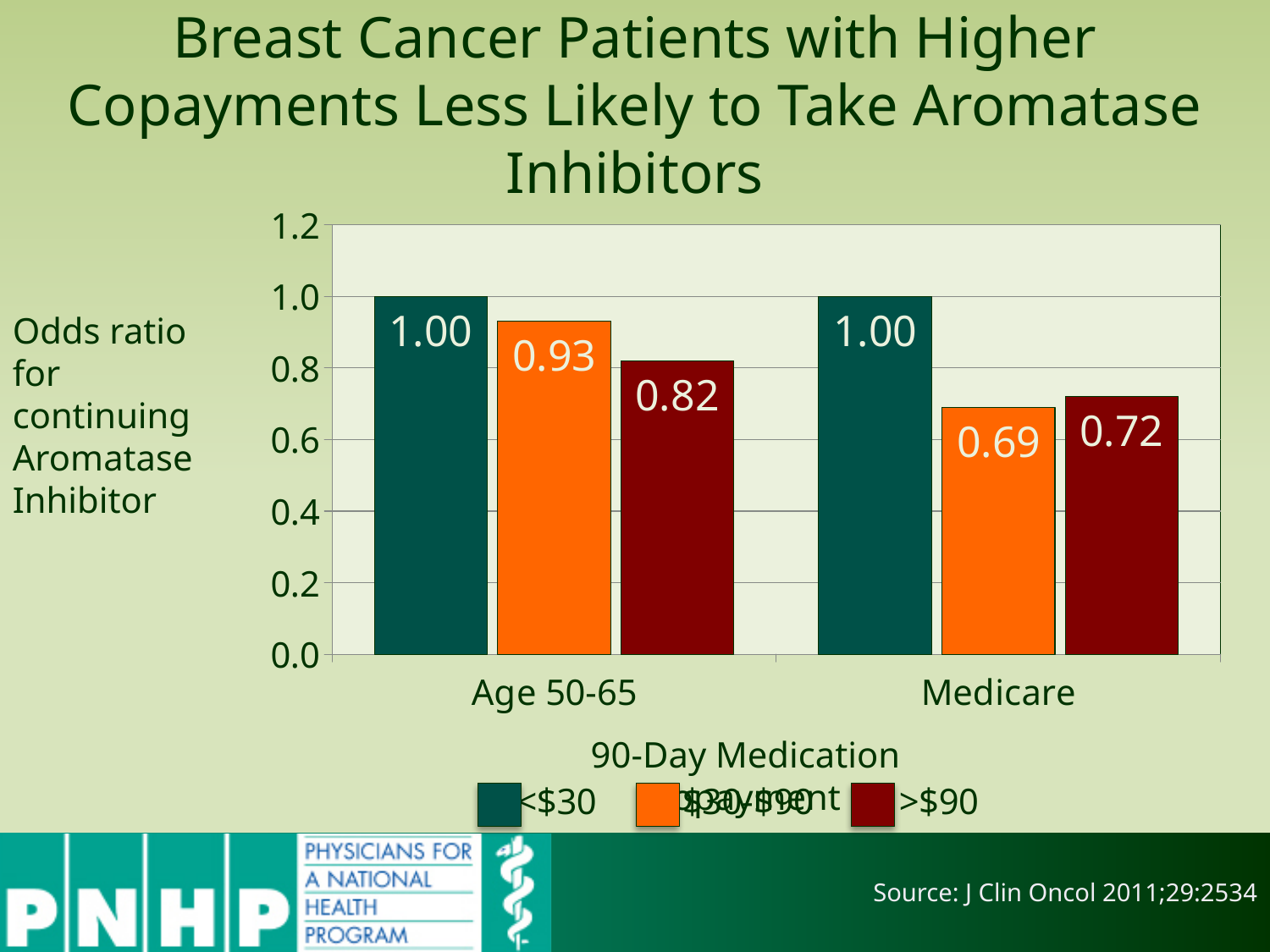
What is the odds ratio for the >$90 copayment group among Medicare patients? 0.72 What is the difference between the odds ratios for the <$30 and >$90 groups among Age 50-65 patients? 0.18 What is the difference between the >$90 odds ratio for Age 50-65 patients and for Medicare patients? 0.10 How many patient groups are shown on the x axis? 2 How many copayment series does the legend list? 3 Is the >$90 odds ratio larger for Age 50-65 patients or for Medicare patients? Age 50-65 What type of chart is shown on the slide? Bar chart Which copayment group has the lowest odds ratio among Age 50-65 patients? >$90 What is the odds ratio for the orange ($30-$90) copayment group among Medicare patients? 0.69 Which copayment group has the lowest odds ratio among Medicare patients? $30-$90 What is the odds ratio for the <$30 copayment group among Age 50-65 patients? 1.00 What is the odds ratio for the >$90 copayment group among Age 50-65 patients? 0.82